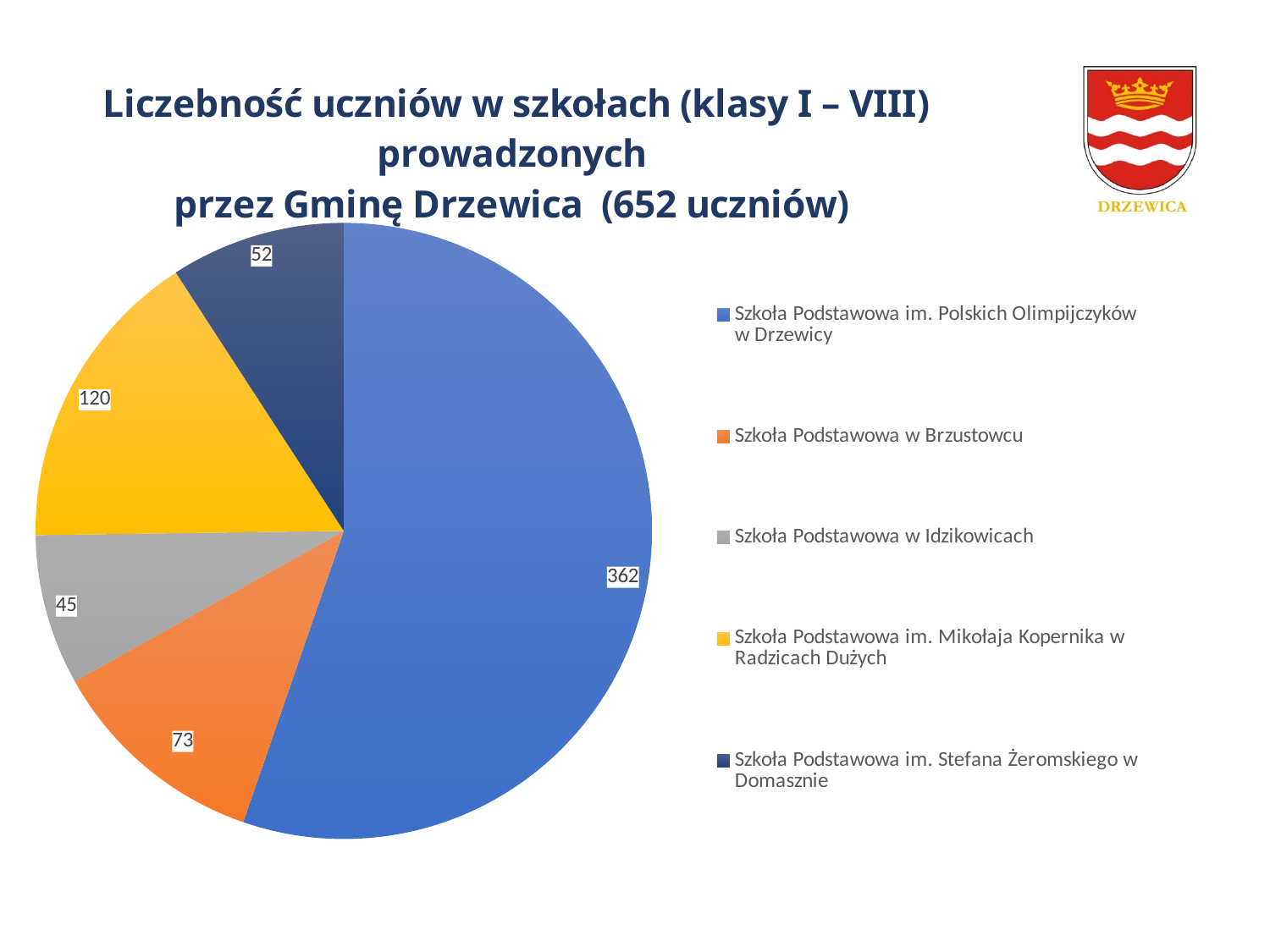
How many students does Szkoła Podstawowa w Brzustowcu have? 73 What is the difference in student numbers between the school in Drzewica and the school in Radzice Duże? 242 Which school has the smallest number of students? Szkoła Podstawowa w Idzikowicach Which school has the largest number of students? Szkoła Podstawowa im. Polskich Olimpijczyków w Drzewicy Which has more students, the school in Brzustowiec or the school in Domaszno? Szkoła Podstawowa w Brzustowcu How many students does Szkoła Podstawowa im. Mikołaja Kopernika w Radzicach Dużych have? 120 How many students does Szkoła Podstawowa im. Stefana Żeromskiego w Domasznie have? 52 How many schools are shown in the pie chart? 5 What kind of chart is shown on the slide? pie chart What share of all 652 students attends Szkoła Podstawowa im. Polskich Olimpijczyków w Drzewicy? 55.5% How many students does Szkoła Podstawowa w Idzikowicach have? 45 How many students does Szkoła Podstawowa im. Polskich Olimpijczyków w Drzewicy have? 362